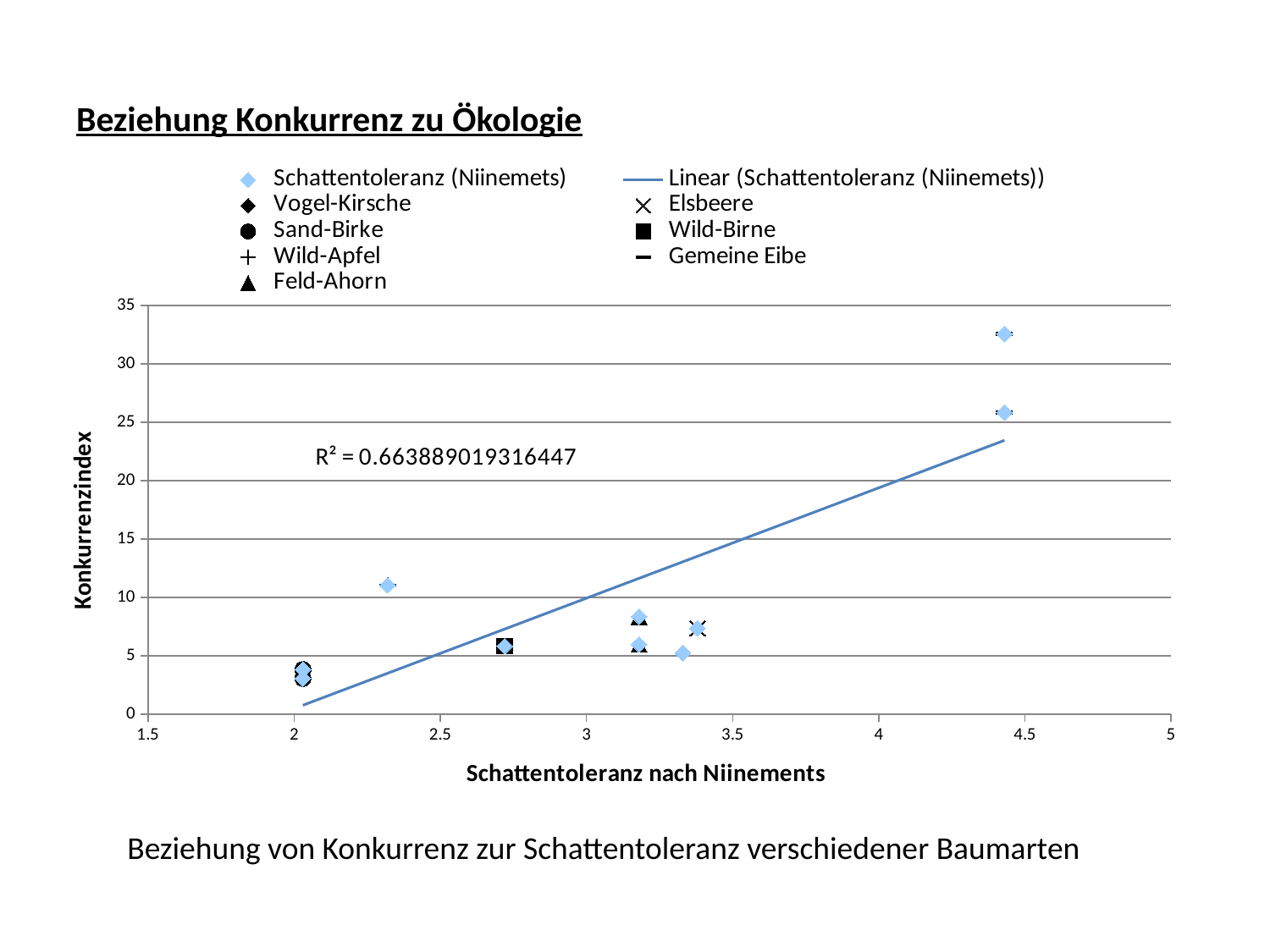
Is the highest plotted Konkurrenzindex value greater or less than 30? greater What R² value is printed on the chart? R² = 0.663889019316447 Which has the higher Konkurrenzindex, Elsbeere or Sand-Birke? Elsbeere Is the Konkurrenzindex value for Elsbeere greater or less than 5? greater Is the Konkurrenzindex value for Wild-Birne greater or less than 10? less How many entries does the chart legend list? 9 Does the linear trend line rise or fall as Schattentoleranz nach Niinements increases? rises What is the title of the y axis? Konkurrenzindex What is the title of the x axis? Schattentoleranz nach Niinements What kind of chart is shown on the slide? scatter chart